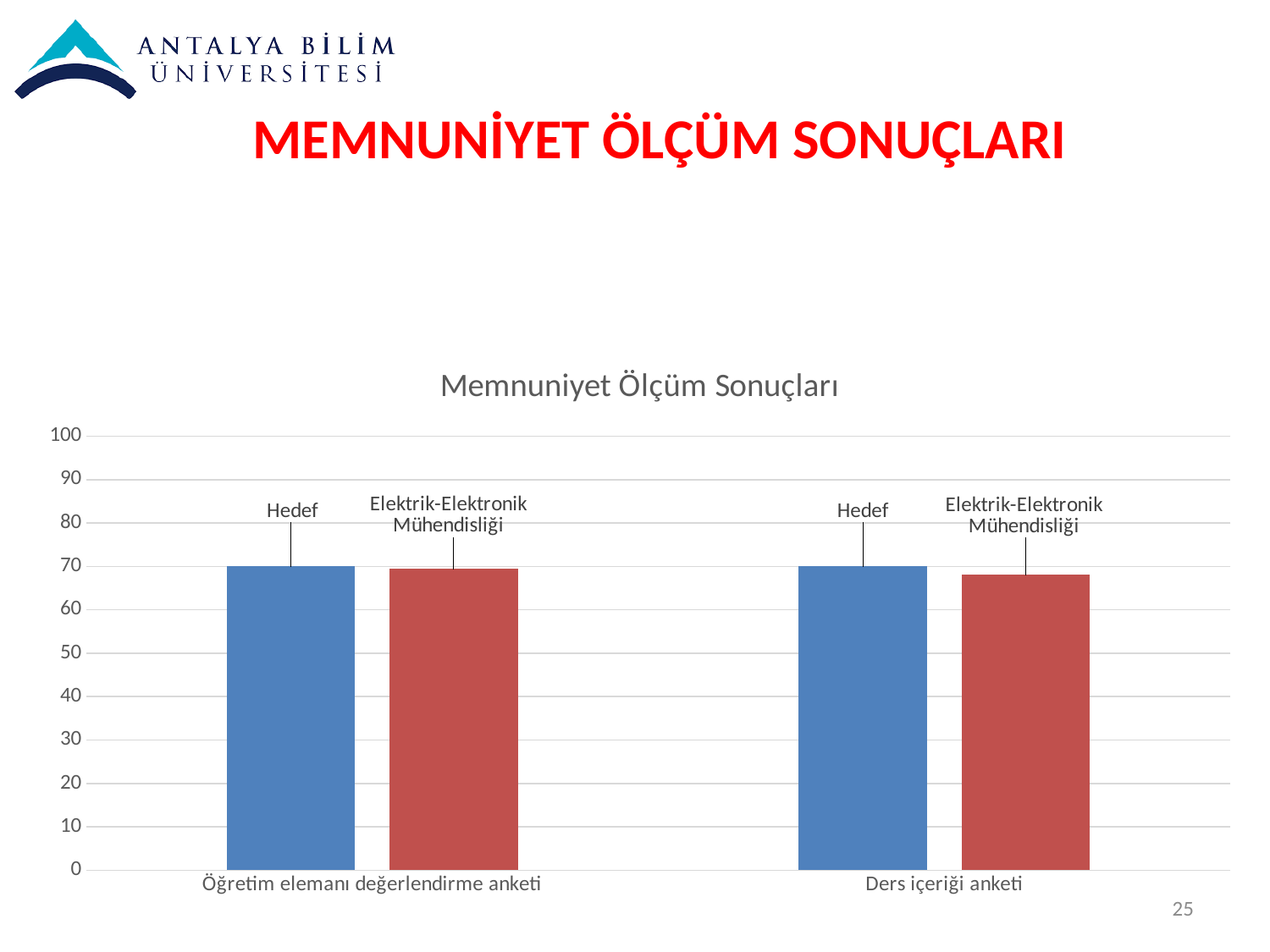
What is the title of the chart? Memnuniyet Ölçüm Sonuçları Is the Elektrik-Elektronik Mühendisliği value for Ders içeriği anketi greater or less than 70? less How many data series are plotted in the chart? 2 What is the highest value shown on the vertical axis of the chart? 100 Which colour represents the Hedef series in the chart? blue Is the Elektrik-Elektronik Mühendisliği value for Ders içeriği anketi greater or less than 60? greater Is the Elektrik-Elektronik Mühendisliği value for Öğretim elemanı değerlendirme anketi greater or less than 60? greater What is the Hedef value for Ders içeriği anketi? 70 For Ders içeriği anketi, which is larger: the Hedef value or the Elektrik-Elektronik Mühendisliği value? Hedef What type of chart is shown on the slide? bar chart What is the Hedef value for Öğretim elemanı değerlendirme anketi? 70 How many categories are shown on the x axis of the chart? 2